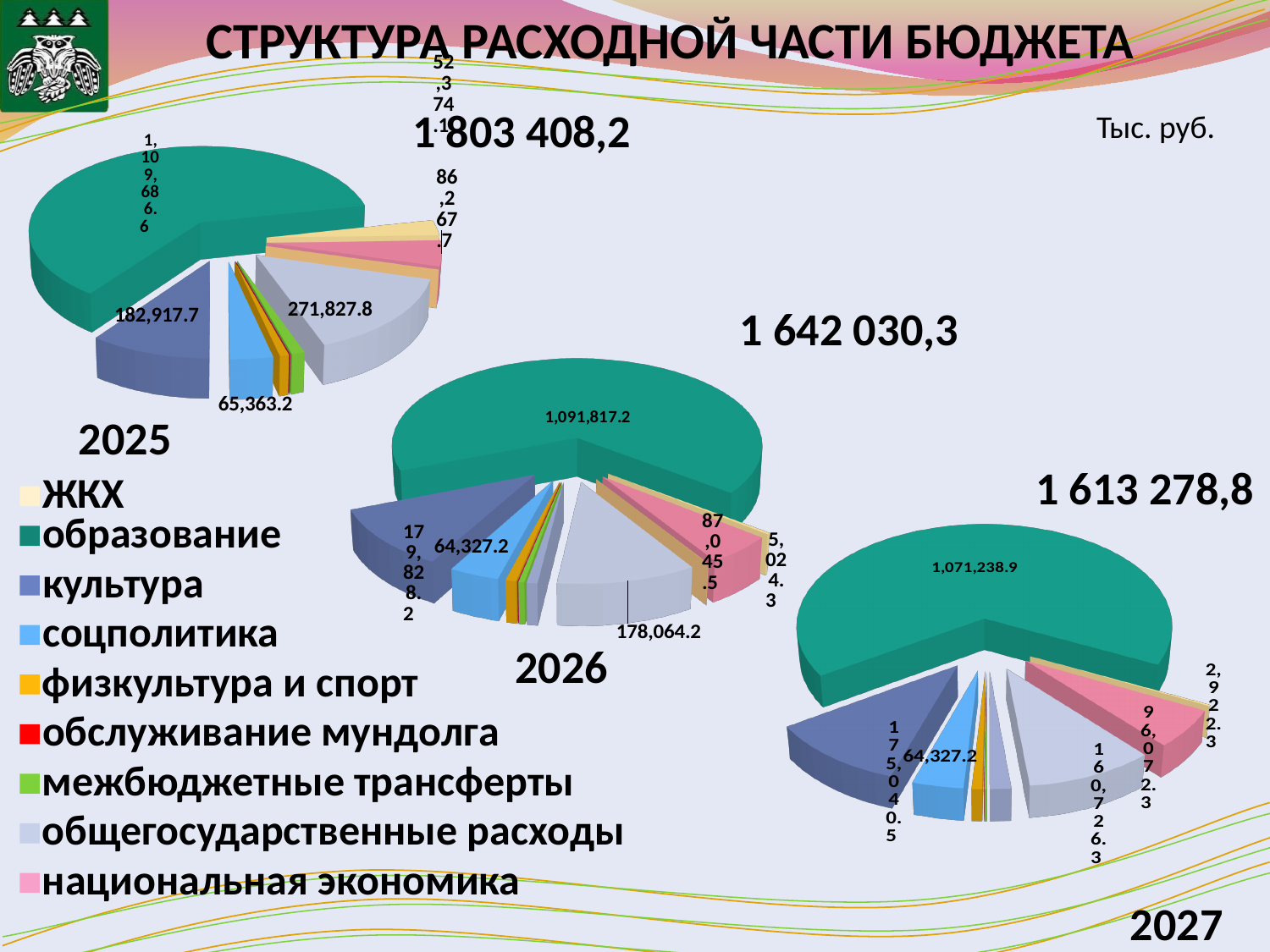
How many pie charts are on the slide? 3 In the 2025 pie chart, what is the value for общегосударственные расходы? 271,827.8 In the 2027 pie chart, what is the difference between культура (175,040.5) and общегосударственные расходы (160,726.3)? 14,314.2 How many categories does the legend list? 9 In the 2026 pie chart, what is the value for соцполитика? 64,327.2 What kind of charts are shown on the slide? Pie charts In the 2027 pie chart, which category has the largest slice? образование In the 2027 pie chart, what is the value for национальная экономика? 96,072.3 Do the budget totals shown for 2025, 2026 and 2027 rise or fall over the years? fall In the 2025 pie chart, which is larger: общегосударственные расходы or культура? общегосударственные расходы In the 2026 pie chart, what is the value for образование? 1,091,817.2 What total is shown above the 2026 pie chart? 1 642 030,3